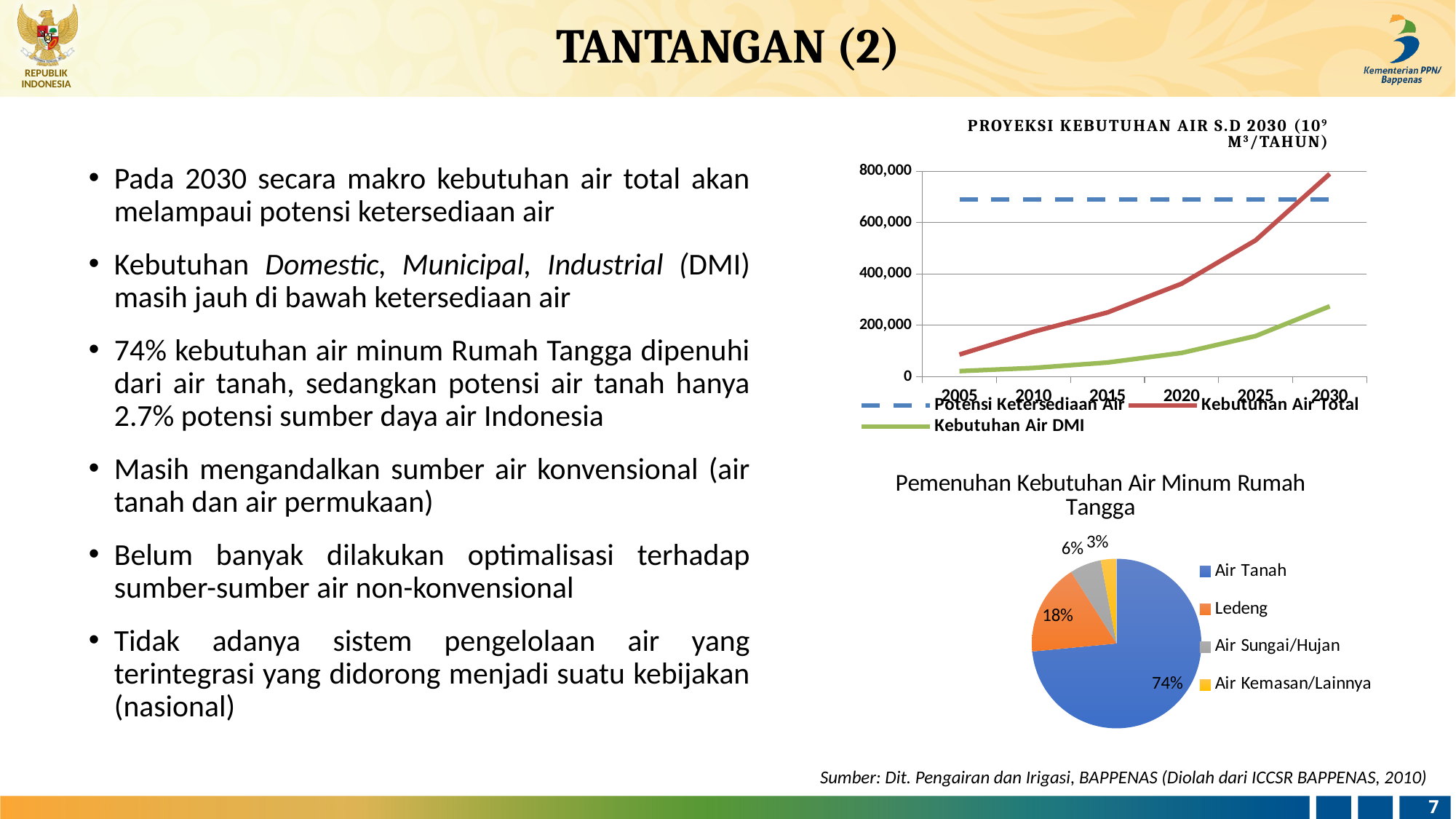
In the pie chart 'Pemenuhan Kebutuhan Air Minum Rumah Tangga', what is the difference between the shares of Air Tanah and Ledeng? 56% In the chart 'PROYEKSI KEBUTUHAN AIR S.D 2030', does Kebutuhan Air Total rise or fall from 2005 to 2030? Rise In the pie chart 'Pemenuhan Kebutuhan Air Minum Rumah Tangga', what share is Air Sungai/Hujan? 6% In the pie chart 'Pemenuhan Kebutuhan Air Minum Rumah Tangga', which category has the smallest share? Air Kemasan/Lainnya In the chart 'PROYEKSI KEBUTUHAN AIR S.D 2030', is the value of Kebutuhan Air Total in 2030 greater or less than 600,000? greater In the pie chart 'Pemenuhan Kebutuhan Air Minum Rumah Tangga', which is larger: Ledeng or Air Sungai/Hujan? Ledeng What kind of chart is 'PROYEKSI KEBUTUHAN AIR S.D 2030'? Line chart In the chart 'PROYEKSI KEBUTUHAN AIR S.D 2030', is the value of Kebutuhan Air DMI in 2005 greater or less than 200,000? less In the pie chart 'Pemenuhan Kebutuhan Air Minum Rumah Tangga', what share is Ledeng? 18% In the pie chart 'Pemenuhan Kebutuhan Air Minum Rumah Tangga', how many categories are shown? 4 In the chart 'PROYEKSI KEBUTUHAN AIR S.D 2030', how many series does the legend list? 3 In the pie chart 'Pemenuhan Kebutuhan Air Minum Rumah Tangga', what share is Air Tanah? 74%